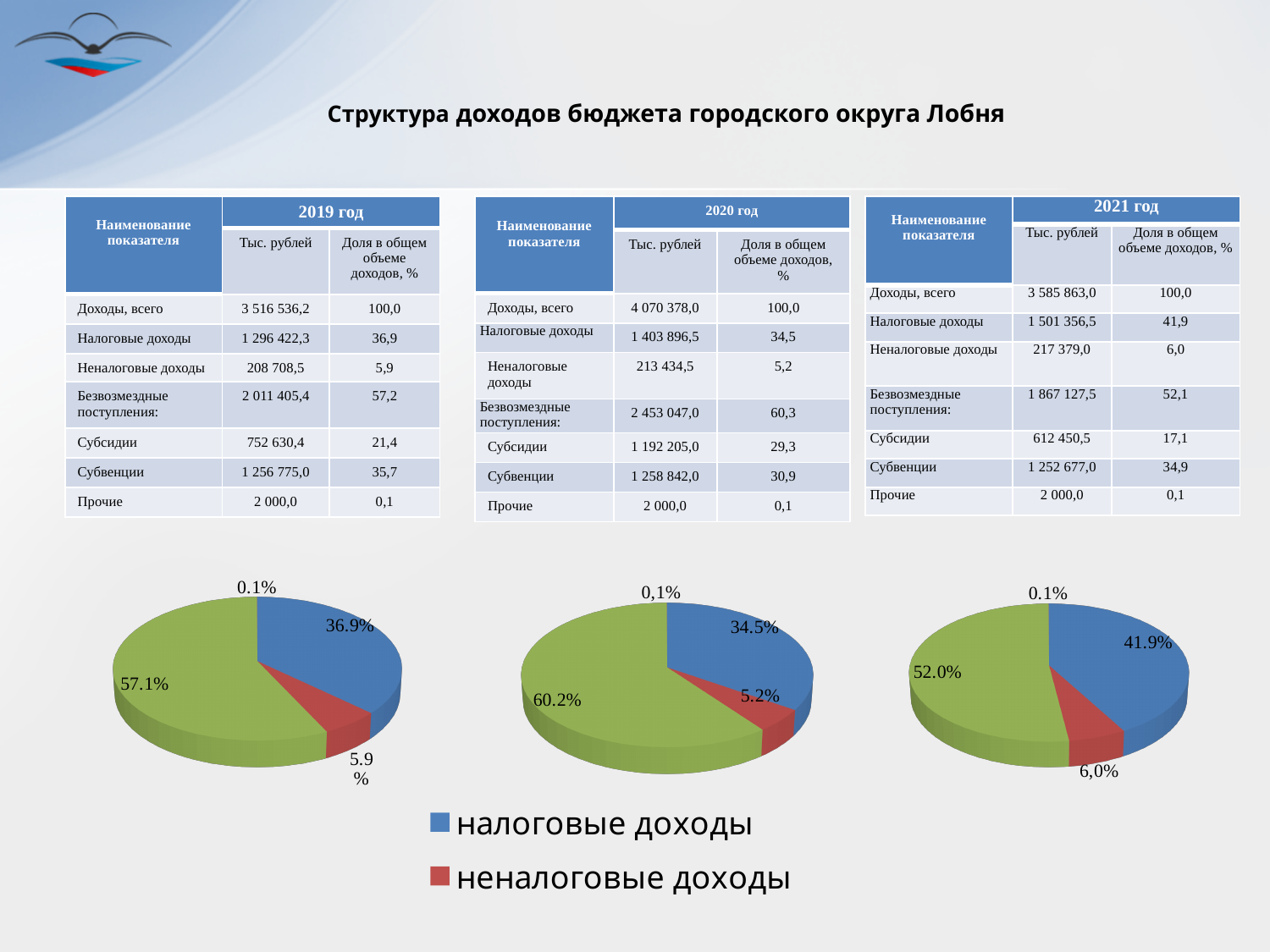
Is the share of налоговые доходы larger in the left pie chart or in the right pie chart? Right pie chart (41.9%) In the middle pie chart, what percentage is shown for the red slice (неналоговые доходы)? 5.2% In the right pie chart, what percentage is shown for the blue slice (налоговые доходы)? 41.9% In the left pie chart, what percentage is shown for the blue slice (налоговые доходы)? 36.9% What kind of chart is the left chart on the slide? Pie chart In the right pie chart, what is the label of the largest slice? 52.0% In the middle pie chart, what percentage is shown for the green slice? 60.2% What colour represents налоговые доходы in the legend? Blue In the left pie chart, what is the difference between the blue slice (36.9%) and the red slice (5.9%)? 31.0 percentage points In the left pie chart, what is the label of the smallest slice? 0.1% How many slices are labelled in the middle pie chart? 4 In the right pie chart, what is the difference between the green slice (52.0%) and the blue slice (41.9%)? 10.1 percentage points